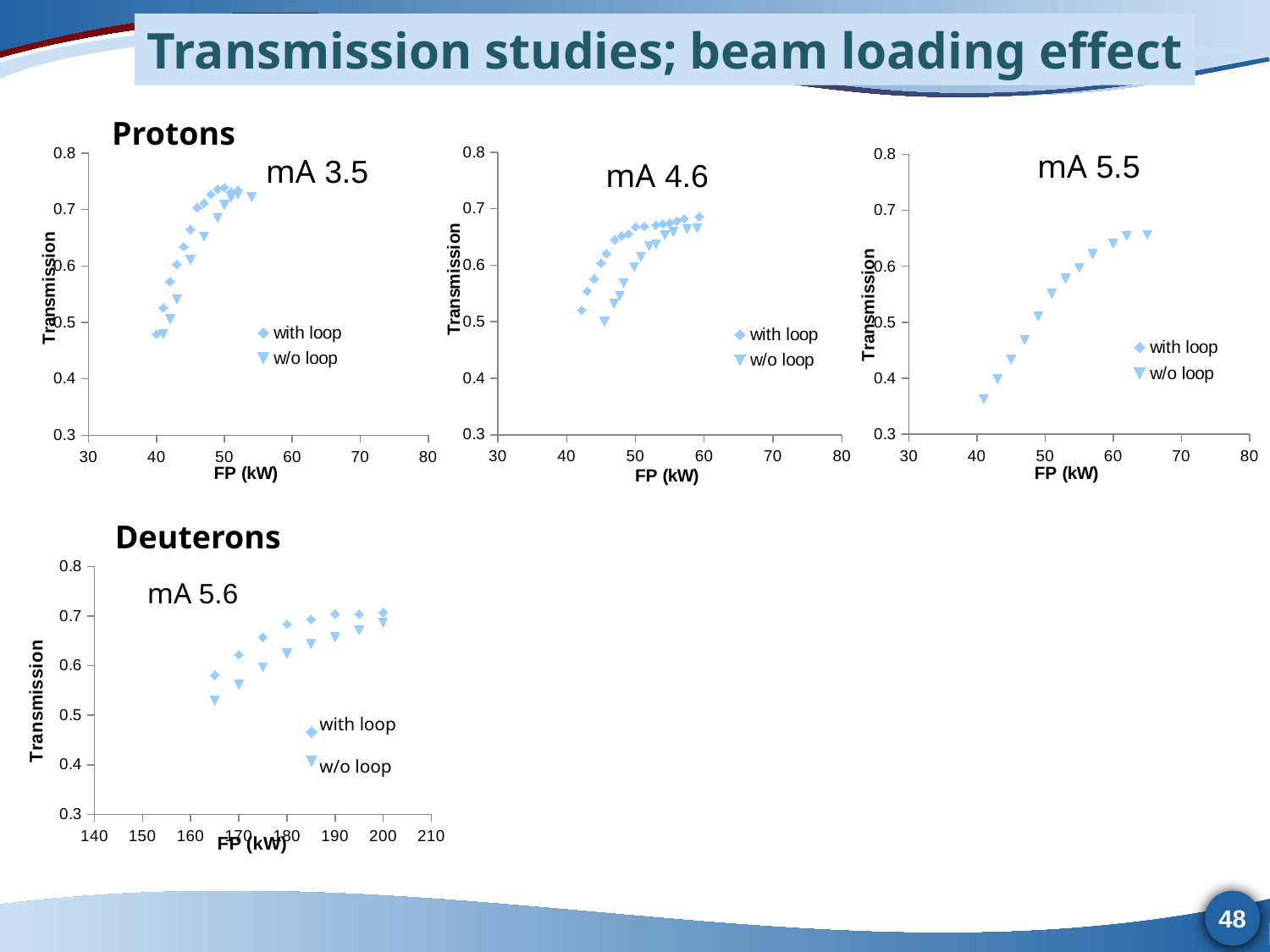
In the "mA 5.5" chart, does transmission rise or fall as FP (kW) increases? rise How many series does the legend of the "mA 4.6" chart list? 2 In the "mA 5.5" chart, what are the two legend entries? with loop, w/o loop In the Deuterons "mA 5.6" chart, does transmission rise or fall as FP (kW) increases? rise In the "mA 5.5" chart, is the lowest plotted transmission value greater or less than 0.4? less In the "mA 4.6" chart, is the highest "with loop" transmission value greater or less than 0.7? less What is the x-axis label of the Deuterons "mA 5.6" chart? FP (kW) In the Deuterons "mA 5.6" chart, is the "with loop" transmission at about 165 kW greater or less than 0.5? greater In the "mA 3.5" chart, at about 45 kW, which series has the higher transmission, "with loop" or "w/o loop"? with loop What kind of chart is the "mA 3.5" chart under Protons? scatter chart In the "mA 4.6" chart, at about 45 kW, which series has the higher transmission, "with loop" or "w/o loop"? with loop How many charts are shown on the slide? 4